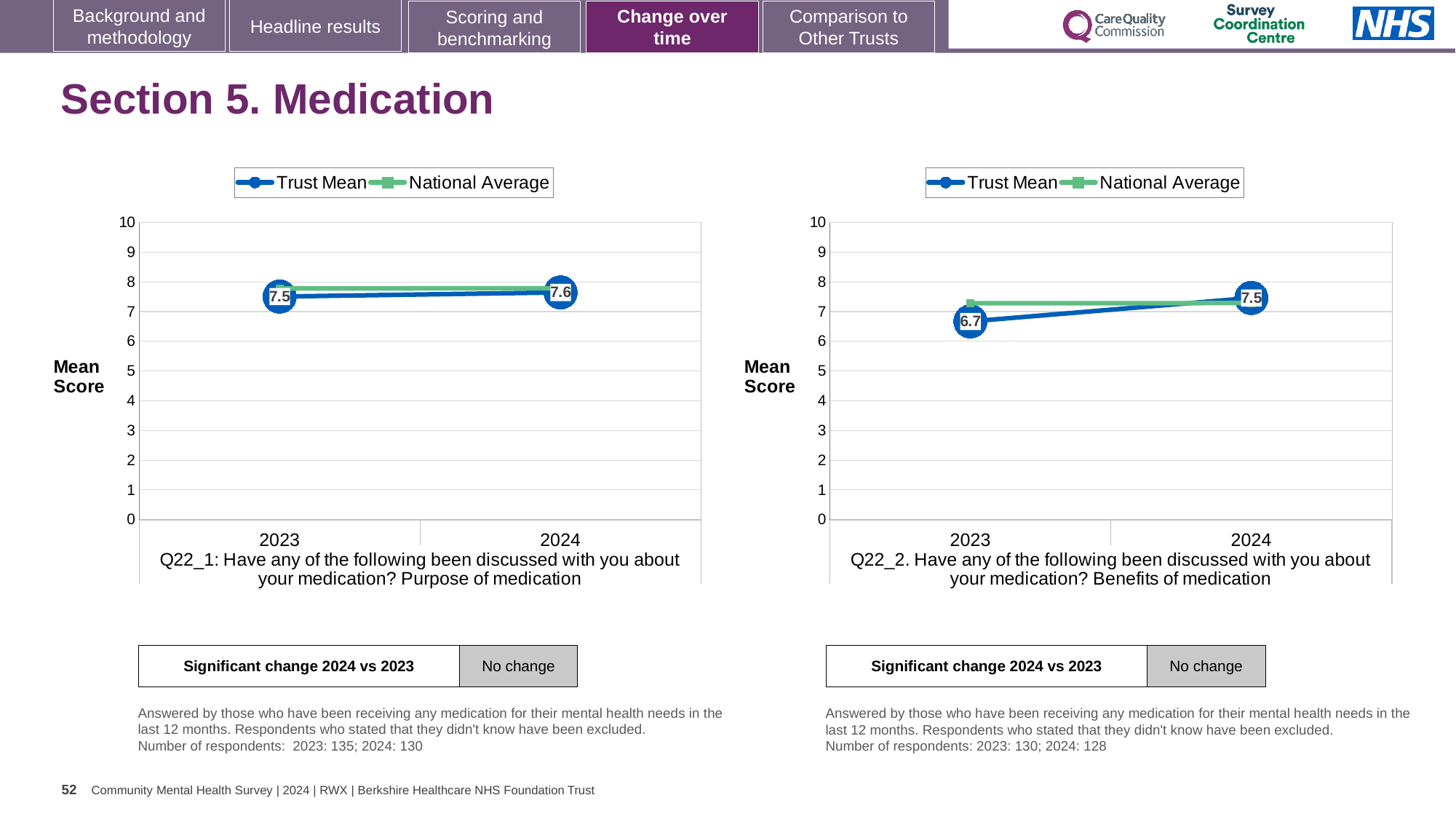
How many series does the legend of the Q22_2 chart (Benefits of medication) list? 2 How many years are plotted on the x axis of the Q22_1 chart (Purpose of medication)? 2 In the Q22_2 chart (Benefits of medication), is the National Average for 2023 greater or less than 7? greater In the Q22_2 chart (Benefits of medication), what is the Trust Mean for 2024? 7.5 In the Q22_1 chart (Purpose of medication), what is the Trust Mean for 2023? 7.5 In the Q22_1 chart (Purpose of medication), what is the Trust Mean for 2024? 7.6 In the Q22_2 chart (Benefits of medication), what is the Trust Mean for 2023? 6.7 In the Q22_1 chart (Purpose of medication), what is the difference between the Trust Mean in 2024 and 2023? 0.1 In the Q22_2 chart (Benefits of medication), does the Trust Mean rise or fall from 2023 to 2024? rise In the Q22_2 chart (Benefits of medication), by how much did the Trust Mean change from 2023 to 2024? 0.8 In the Q22_2 chart (Benefits of medication), which is larger in 2023: the Trust Mean or the National Average? National Average What kind of chart is used for Q22_1 (Purpose of medication)? line chart